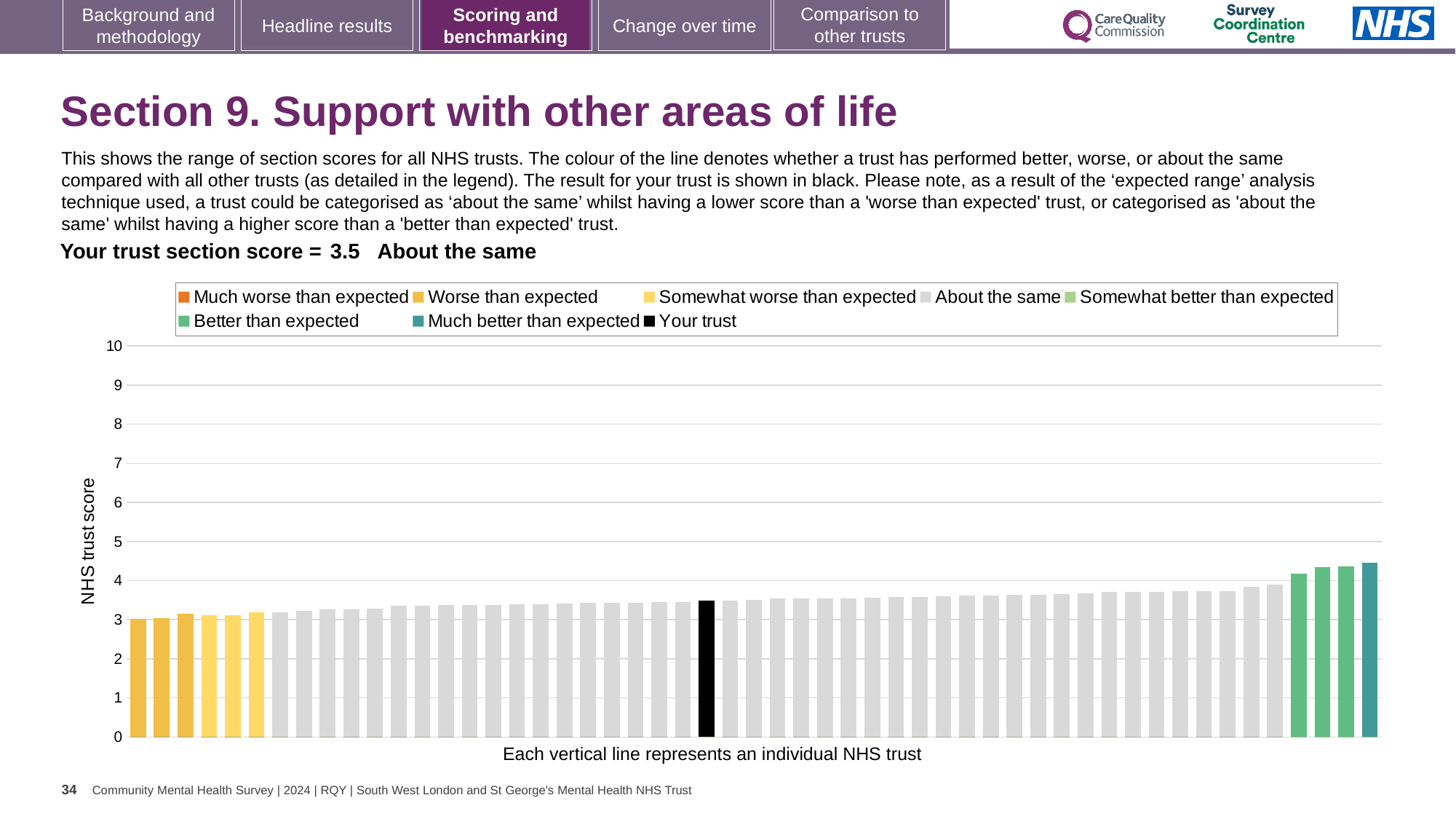
What is the label on the vertical axis of the chart? NHS trust score Is the value of the black bar (your trust) greater or less than 4? less What is the section score for your trust shown on the slide? 3.5 According to the x-axis caption, what does each vertical line in the chart represent? An individual NHS trust What kind of chart is shown on the slide? bar chart Is the value of the tallest bar greater or less than 4? greater How many bars are coloured as 'Much better than expected' (teal)? 1 How many entries does the chart legend list? 8 Is the value of the black bar (your trust) greater or less than 3? greater Which category is your trust placed in for this section? About the same Do the bar values rise or fall from left to right along the x axis? rise